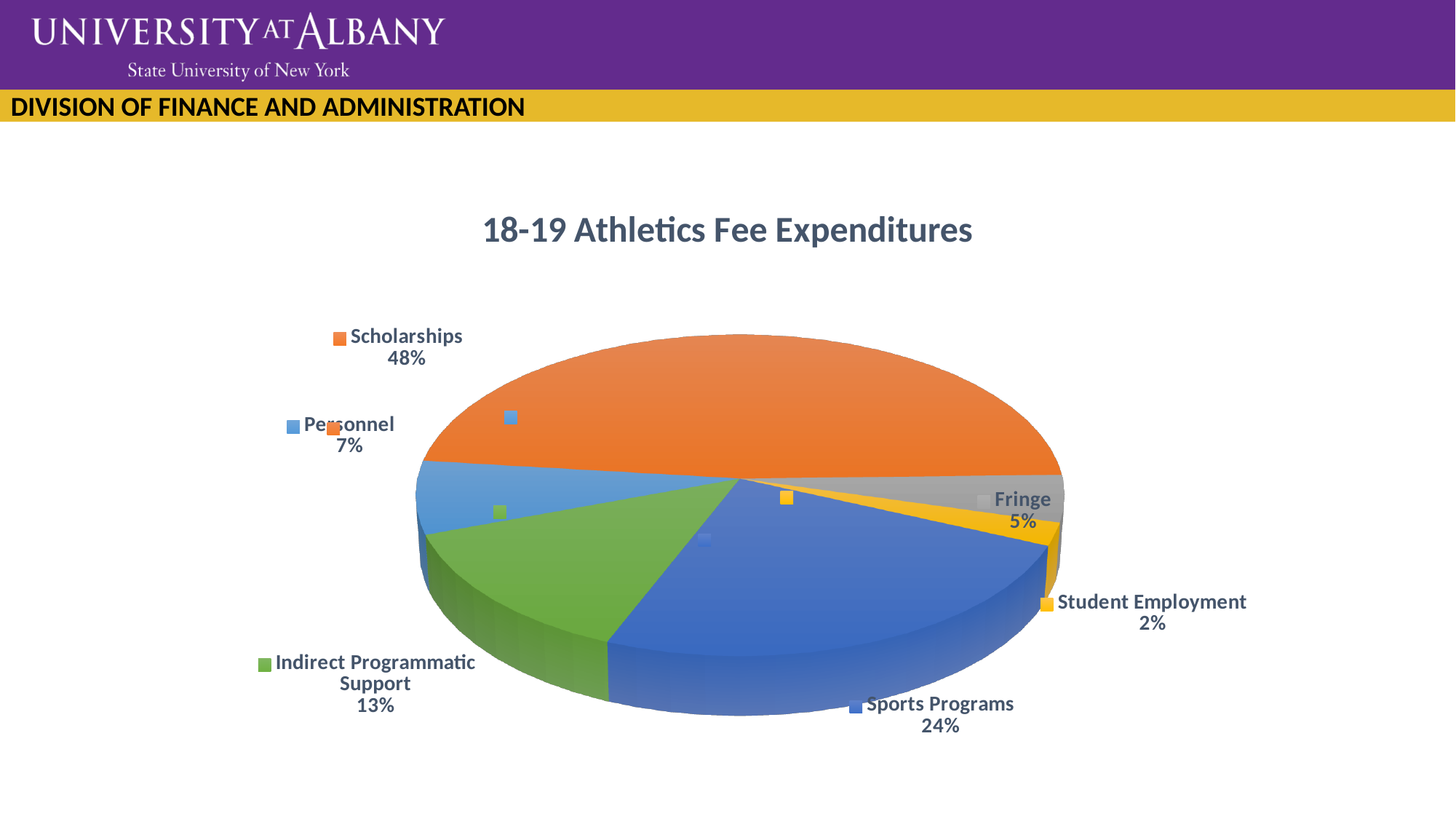
What is the difference in percentage points between Scholarships and Sports Programs? 24 percentage points What percentage of expenditures is for Sports Programs? 24% Which category has the smallest share of expenditures? Student Employment What percentage of expenditures is for Personnel? 7% What percentage of expenditures is for Indirect Programmatic Support? 13% What is the title of the chart? 18-19 Athletics Fee Expenditures Which category has the largest share of expenditures? Scholarships How many categories are shown in the pie chart? 6 What percentage of expenditures is for Fringe? 5% What share of the 18-19 Athletics Fee Expenditures goes to Scholarships? 48% What percentage of expenditures is for Student Employment? 2% What kind of chart is shown on the slide? Pie chart